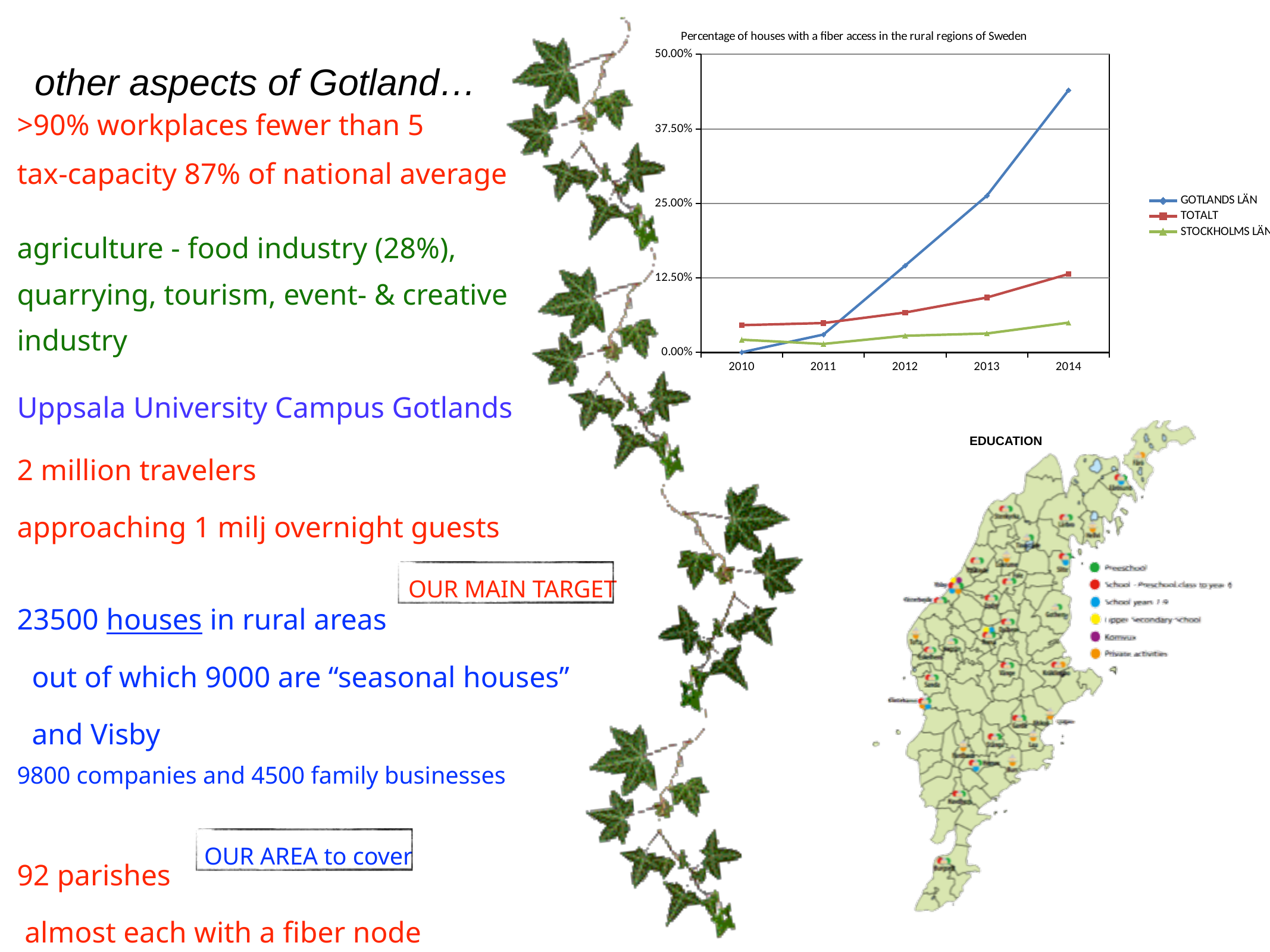
Is the value for TOTALT in 2014 greater or less than 25.00%? less What kind of chart is shown on the slide? line chart In which year does GOTLANDS LÄN reach its highest value? 2014 Is the value for GOTLANDS LÄN in 2014 greater or less than 37.50%? greater How many years are shown on the x axis of the chart? 5 Which series has the highest value in 2014? GOTLANDS LÄN Is the value for STOCKHOLMS LÄN in 2014 greater or less than 12.50%? less Which is larger in 2012, the value for GOTLANDS LÄN or the value for TOTALT? GOTLANDS LÄN How many series does the chart legend list? 3 Does the value for GOTLANDS LÄN rise or fall from 2010 to 2014? rise Which series has the lowest value in 2014? STOCKHOLMS LÄN What is the title of the chart? Percentage of houses with a fiber access in the rural regions of Sweden